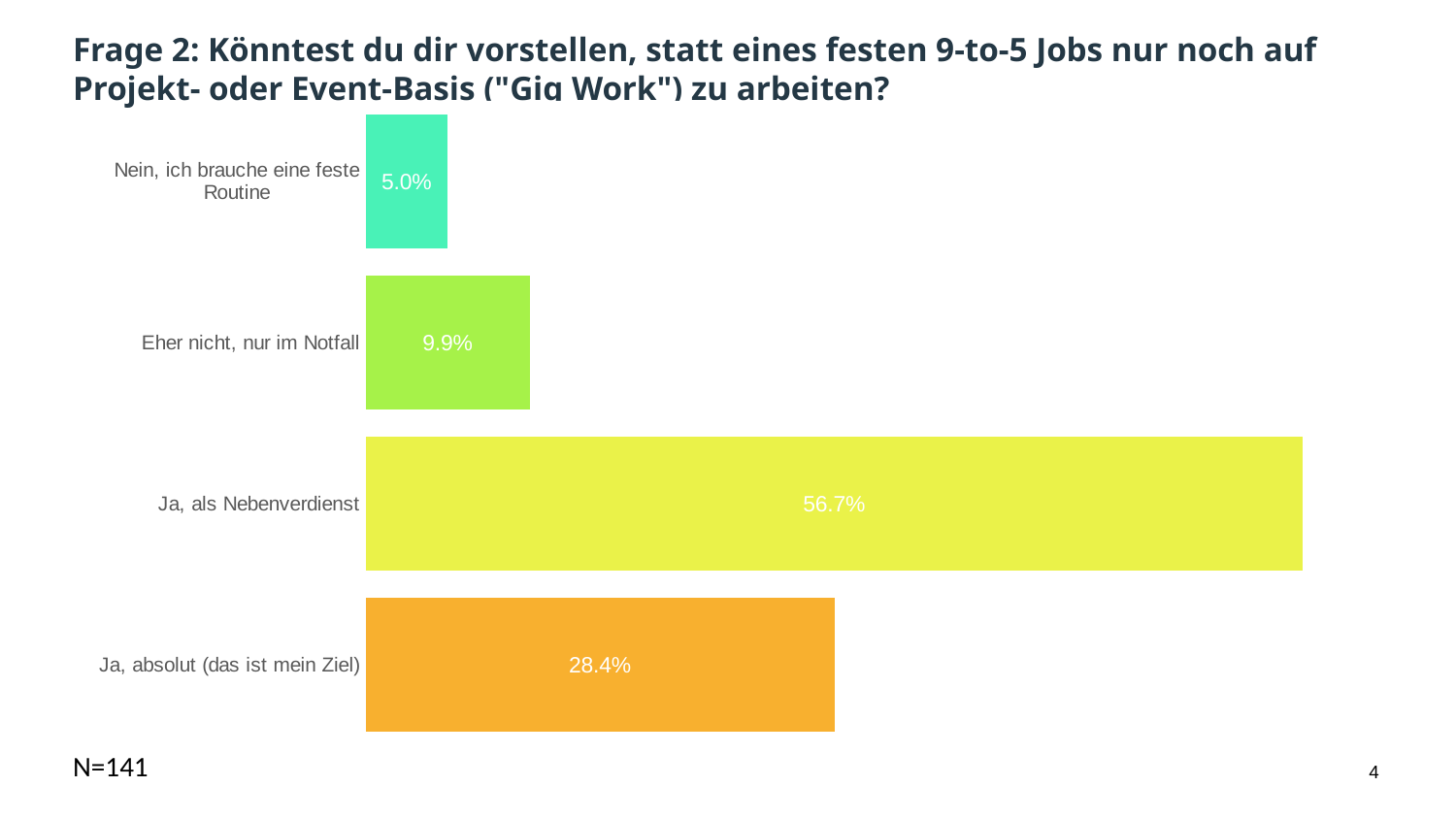
What is the value for "Ja, absolut (das ist mein Ziel)"? 28.4% Which category has the highest value? Ja, als Nebenverdienst What is the difference between "Ja, als Nebenverdienst" and "Ja, absolut (das ist mein Ziel)"? 28.3% Which is larger, "Ja, absolut (das ist mein Ziel)" or "Eher nicht, nur im Notfall"? Ja, absolut (das ist mein Ziel) What is the value for "Ja, als Nebenverdienst"? 56.7% How many categories are shown in the chart? 4 Which category has the lowest value? Nein, ich brauche eine feste Routine What is the value for "Eher nicht, nur im Notfall"? 9.9% What is the difference between "Eher nicht, nur im Notfall" and "Nein, ich brauche eine feste Routine"? 4.9% What sample size (N) is stated on the slide? N=141 What is the value for "Nein, ich brauche eine feste Routine"? 5.0% What kind of chart is shown on the slide? Bar chart